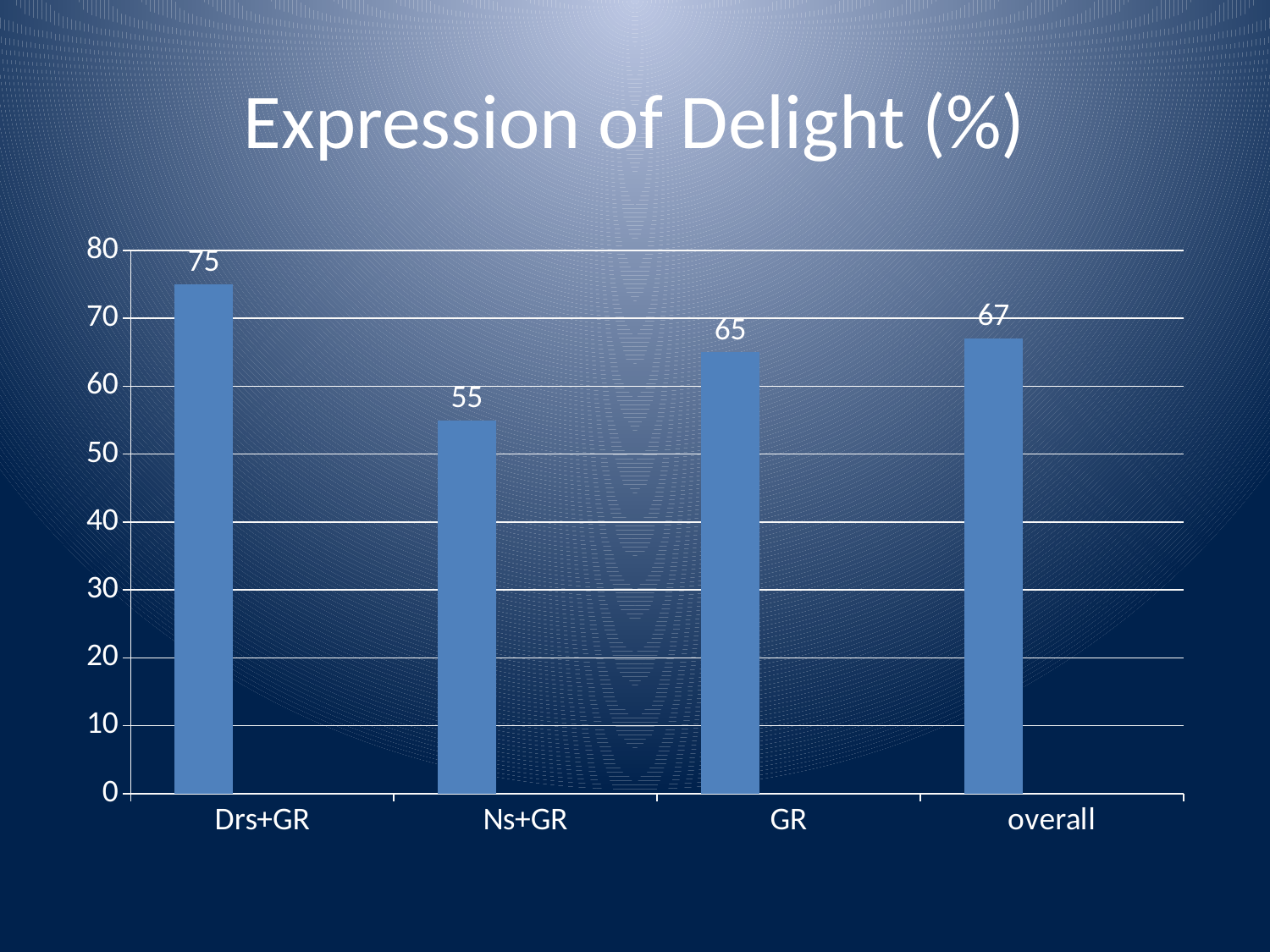
Which is larger, the value for GR or the value for Ns+GR? GR What is the value for overall? 67 What is the value for Ns+GR? 55 Is the value for Ns+GR greater or less than 60? less Which category has the highest value? Drs+GR What kind of chart is shown on the slide? bar chart What is the value for GR? 65 What is the value for Drs+GR? 75 Which category has the lowest value? Ns+GR What is the difference between the values for overall and GR? 2 What is the difference between the values for Drs+GR and Ns+GR? 20 How many categories are shown on the x axis? 4